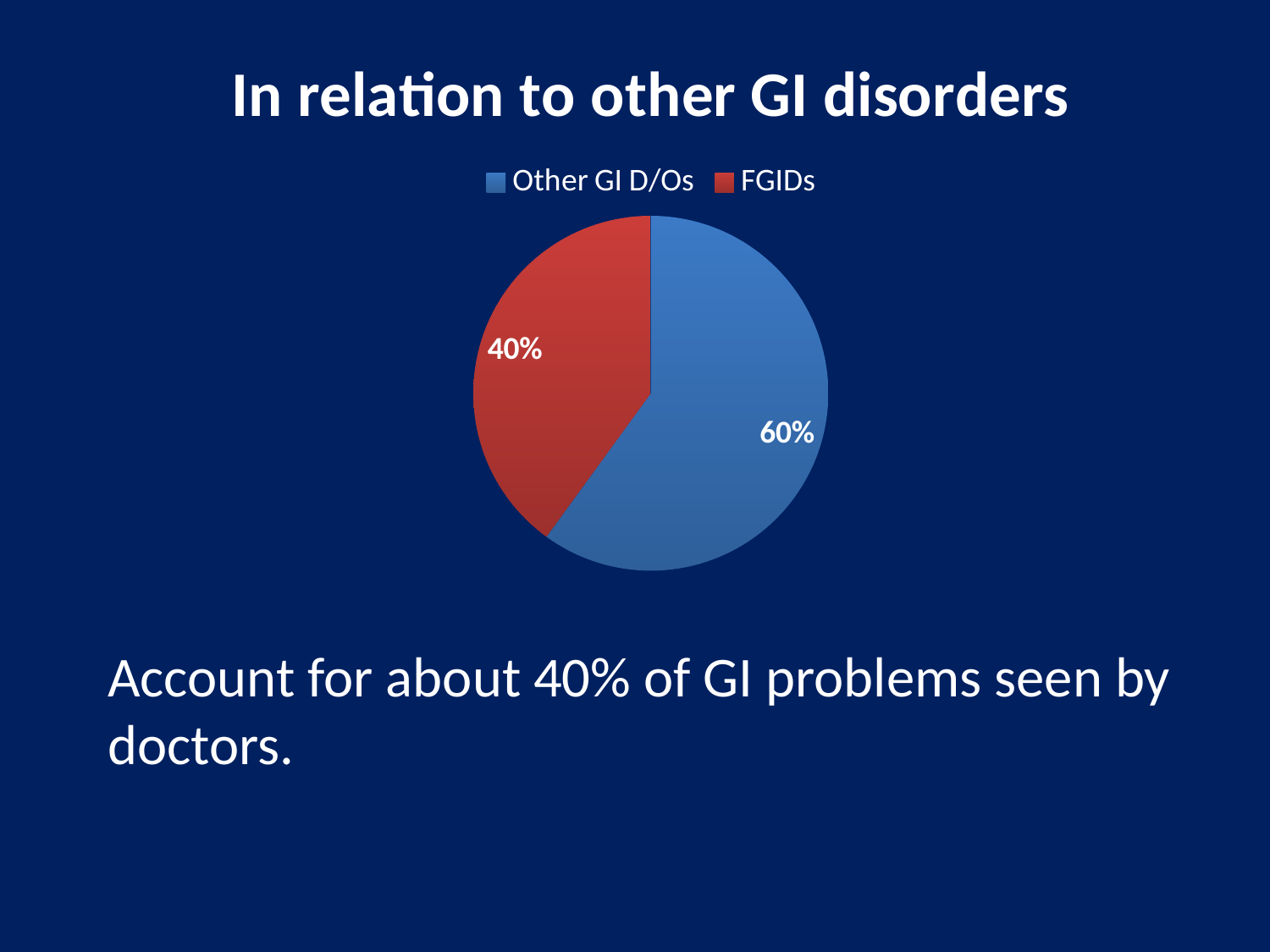
What colour is the FGIDs slice? red What kind of chart is shown on the slide? pie chart What share of the pie does Other GI D/Os account for? 60% Which slice of the pie is the smallest? FGIDs How many entries does the legend list? 2 What is the title of the chart? In relation to other GI disorders What is the difference in percentage points between the Other GI D/Os slice and the FGIDs slice? 20 percentage points Which slice of the pie is the largest? Other GI D/Os What share of the pie does FGIDs account for? 40% How many slices does the pie chart have? 2 Which is larger, the FGIDs slice or the Other GI D/Os slice? Other GI D/Os